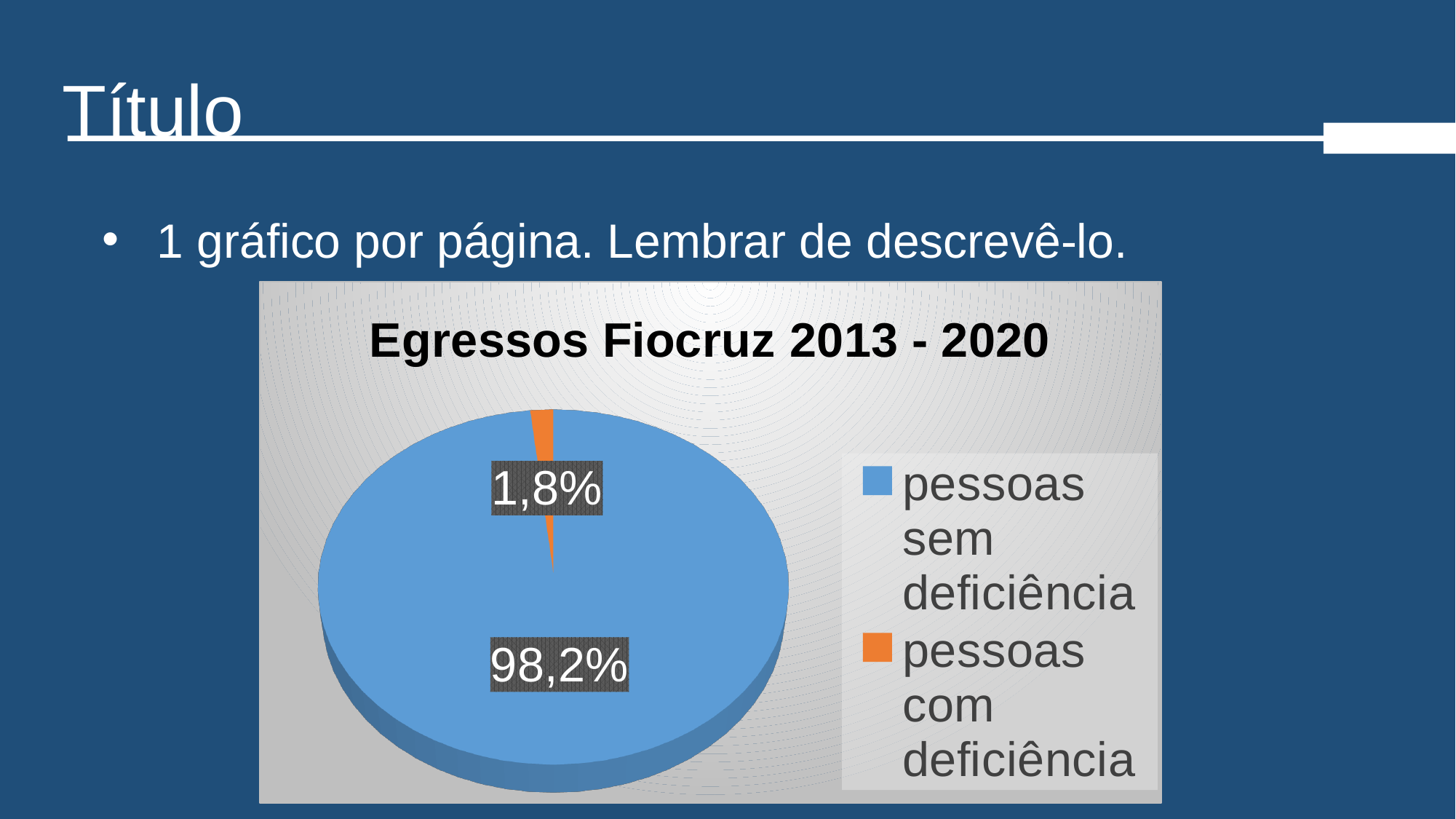
What is the title of the chart? Egressos Fiocruz 2013 - 2020 What share of the pie is labelled for 'pessoas com deficiência'? 1,8% What kind of chart is shown on the slide? pie chart Which category has the smallest slice of the pie? pessoas com deficiência Which category has the largest slice of the pie? pessoas sem deficiência How many categories does the legend list? 2 Which is larger, the slice for 'pessoas sem deficiência' or the slice for 'pessoas com deficiência'? pessoas sem deficiência What colour is the slice for 'pessoas com deficiência'? orange What is the difference in percentage points between the 'pessoas sem deficiência' and 'pessoas com deficiência' slices? 96,4 What is the total of the two labelled slices? 100% What share of the pie is labelled for 'pessoas sem deficiência'? 98,2%